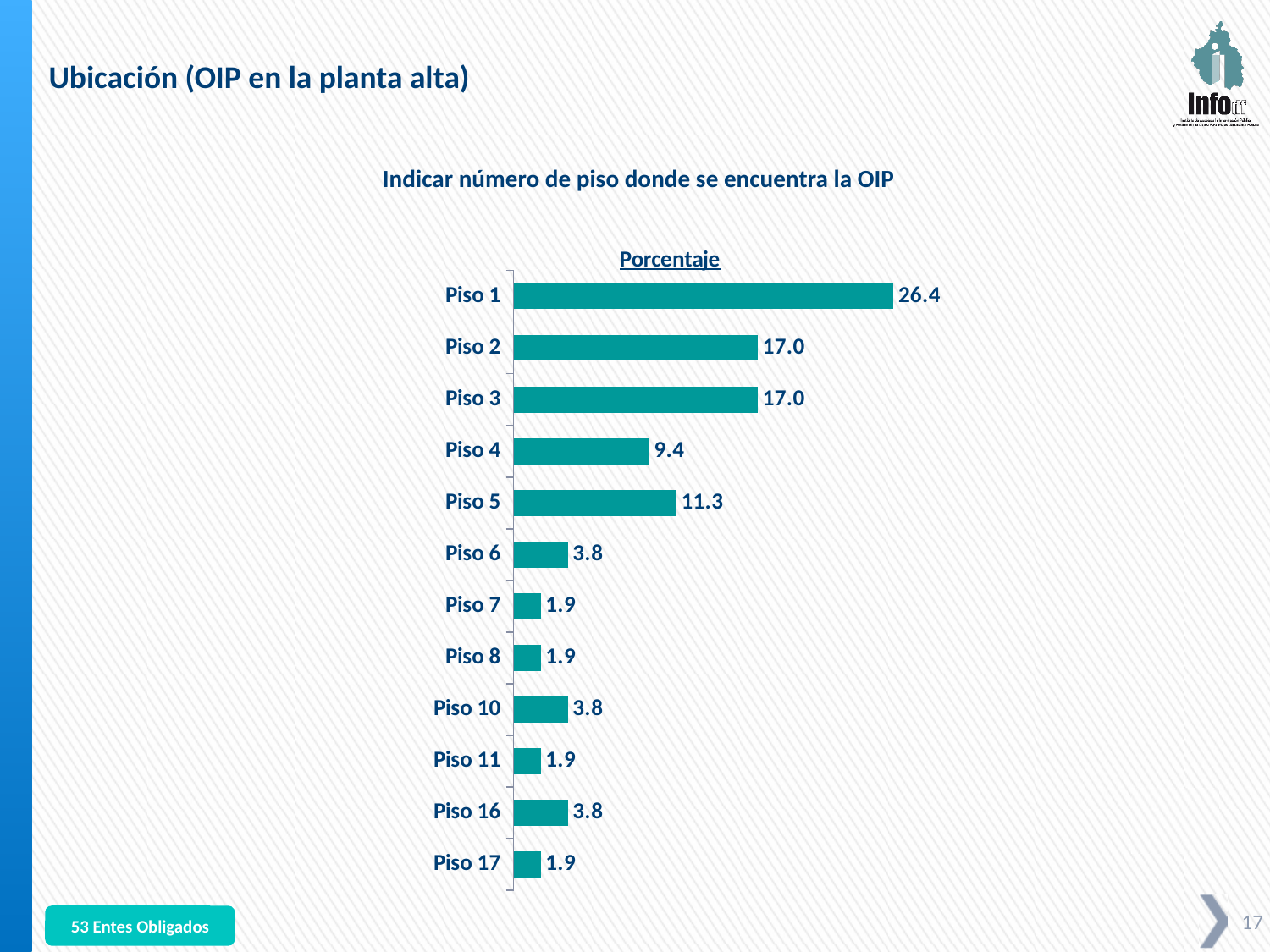
Which category has the highest value? Piso 1 Which is larger, the value for Piso 6 or the value for Piso 7? Piso 6 What is the difference between the values for Piso 1 and Piso 2? 9.4 How many categories are shown in the chart? 12 What is the difference between the values for Piso 5 and Piso 4? 1.9 What is the value for Piso 4? 9.4 Do Piso 2 and Piso 3 have the same value? Yes Which is larger, the value for Piso 4 or the value for Piso 5? Piso 5 What is the value for Piso 1? 26.4 What is the title of the chart? Porcentaje What kind of chart is shown on the slide? Bar chart What is the value for Piso 5? 11.3